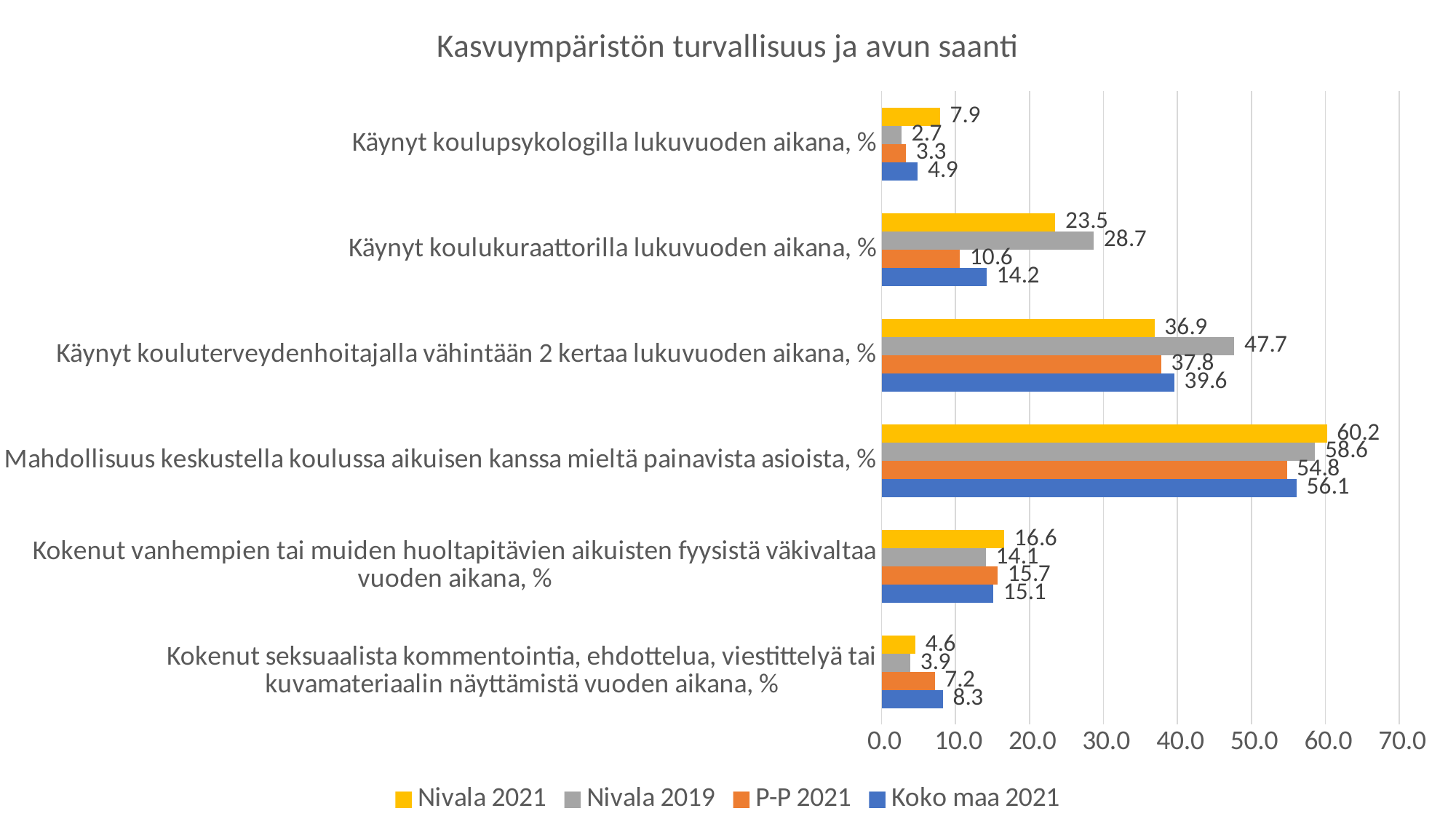
Is the Nivala 2021 value for "Mahdollisuus keskustella koulussa aikuisen kanssa mieltä painavista asioista, %" greater or less than 50.0? greater What is the Nivala 2019 value for "Käynyt koulukuraattorilla lukuvuoden aikana, %"? 28.7 What is the Koko maa 2021 value for "Kokenut seksuaalista kommentointia, ehdottelua, viestittelyä tai kuvamateriaalin näyttämistä vuoden aikana, %"? 8.3 Which series has the lowest value for "Mahdollisuus keskustella koulussa aikuisen kanssa mieltä painavista asioista, %"? P-P 2021 What is the difference between the Nivala 2021 and P-P 2021 values for "Käynyt koulukuraattorilla lukuvuoden aikana, %"? 12.9 What is the title of the chart? Kasvuympäristön turvallisuus ja avun saanti What is the Nivala 2021 value for "Käynyt koulupsykologilla lukuvuoden aikana, %"? 7.9 How many series does the legend list? 4 What kind of chart is shown on the slide? Bar chart For "Kokenut vanhempien tai muiden huoltapitävien aikuisten fyysistä väkivaltaa vuoden aikana, %", which is larger: Nivala 2021 or Nivala 2019? Nivala 2021 Which series has the highest value for "Käynyt kouluterveydenhoitajalla vähintään 2 kertaa lukuvuoden aikana, %"? Nivala 2019 How many categories are shown on the y axis of the chart? 6